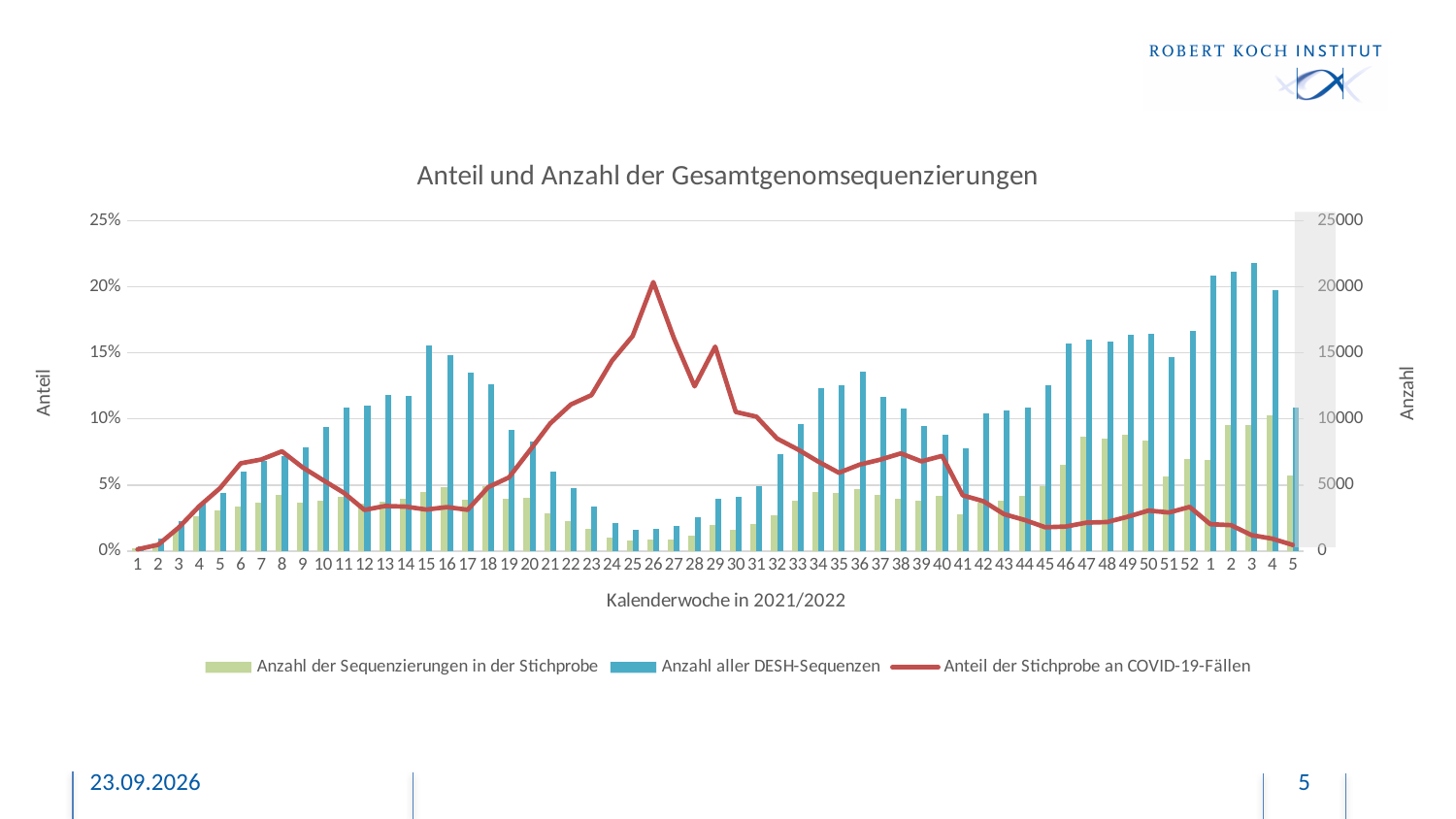
Is the value of 'Anzahl aller DESH-Sequenzen' in calendar week 3 of 2022 greater or less than 20000? greater Do the bars for 'Anzahl aller DESH-Sequenzen' rise or fall from calendar week 45 of 2021 to calendar week 3 of 2022? Rise In which calendar week does the line 'Anteil der Stichprobe an COVID-19-Fällen' reach its highest value? 26 Does the line 'Anteil der Stichprobe an COVID-19-Fällen' rise or fall from calendar week 26 to calendar week 45 of 2021? Fall What kind of chart is shown on the slide? A combined bar and line chart What is the title of the chart? Anteil und Anzahl der Gesamtgenomsequenzierungen Is the value of 'Anteil der Stichprobe an COVID-19-Fällen' in calendar week 5 of 2022 greater or less than 5%? less Which is larger: 'Anzahl aller DESH-Sequenzen' in calendar week 26 of 2021 or in calendar week 3 of 2022? Calendar week 3 of 2022 Which series is drawn as a red line? Anteil der Stichprobe an COVID-19-Fällen Is the value of 'Anteil der Stichprobe an COVID-19-Fällen' in calendar week 26 greater or less than 15%? greater How many series does the legend list? 3 How many calendar weeks are plotted along the x axis? 57